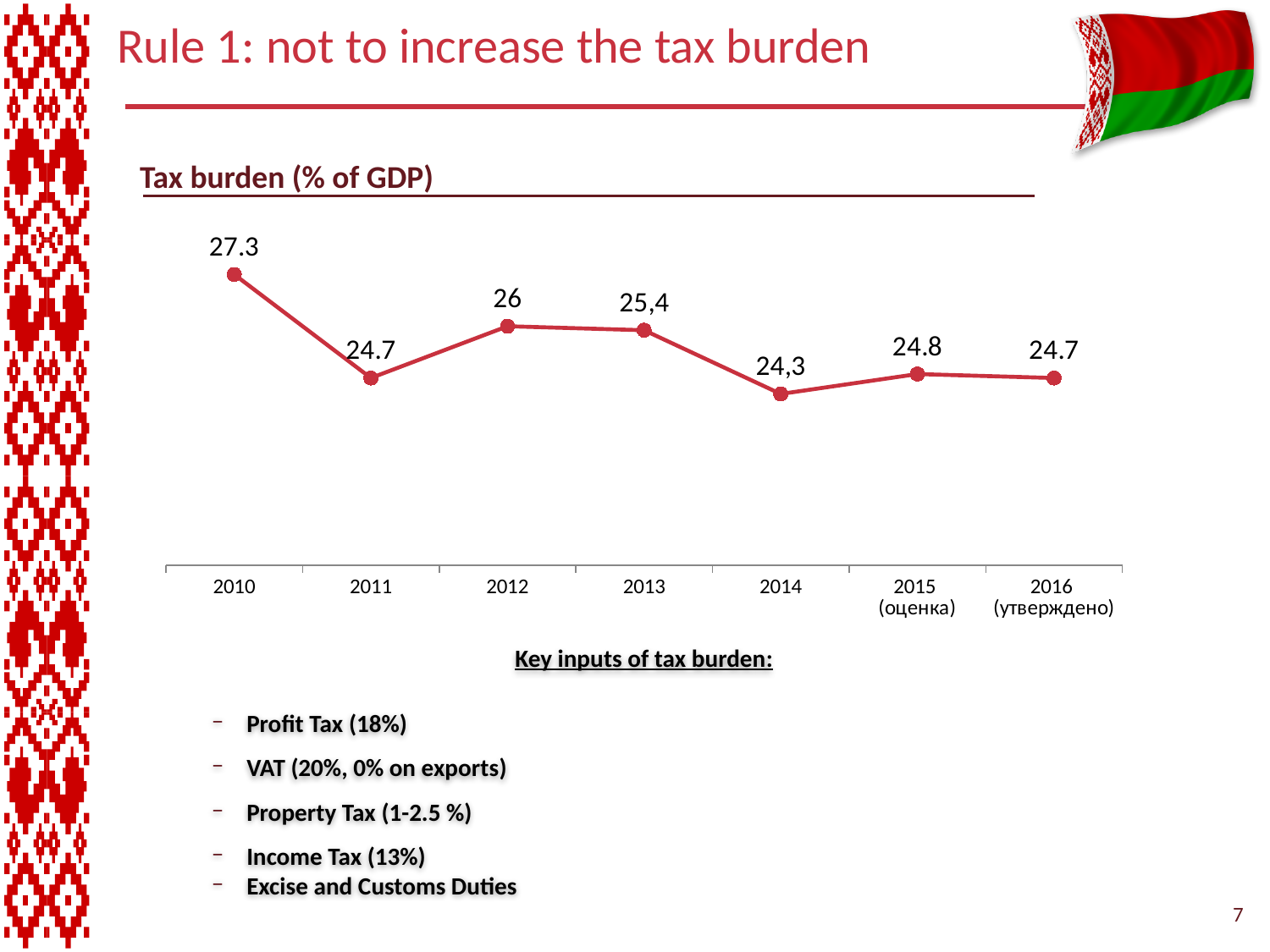
Which year has a higher tax burden, 2012 or 2013? 2012 What is the tax burden (% of GDP) for 2010? 27.3 What kind of chart is used to show the tax burden (% of GDP)? line chart What is the tax burden (% of GDP) for 2013? 25,4 Does the tax burden rise or fall from 2010 to 2011? fall Which year has the highest tax burden (% of GDP)? 2010 How many years are plotted on the tax burden chart? 7 What is the difference between the tax burden in 2012 and in 2011? 1.3 What is the tax burden (% of GDP) for 2015 (оценка)? 24.8 What is the tax burden (% of GDP) for 2016 (утверждено)? 24.7 Which year has the lowest tax burden (% of GDP)? 2014 What is the difference between the tax burden in 2010 and in 2011? 2.6